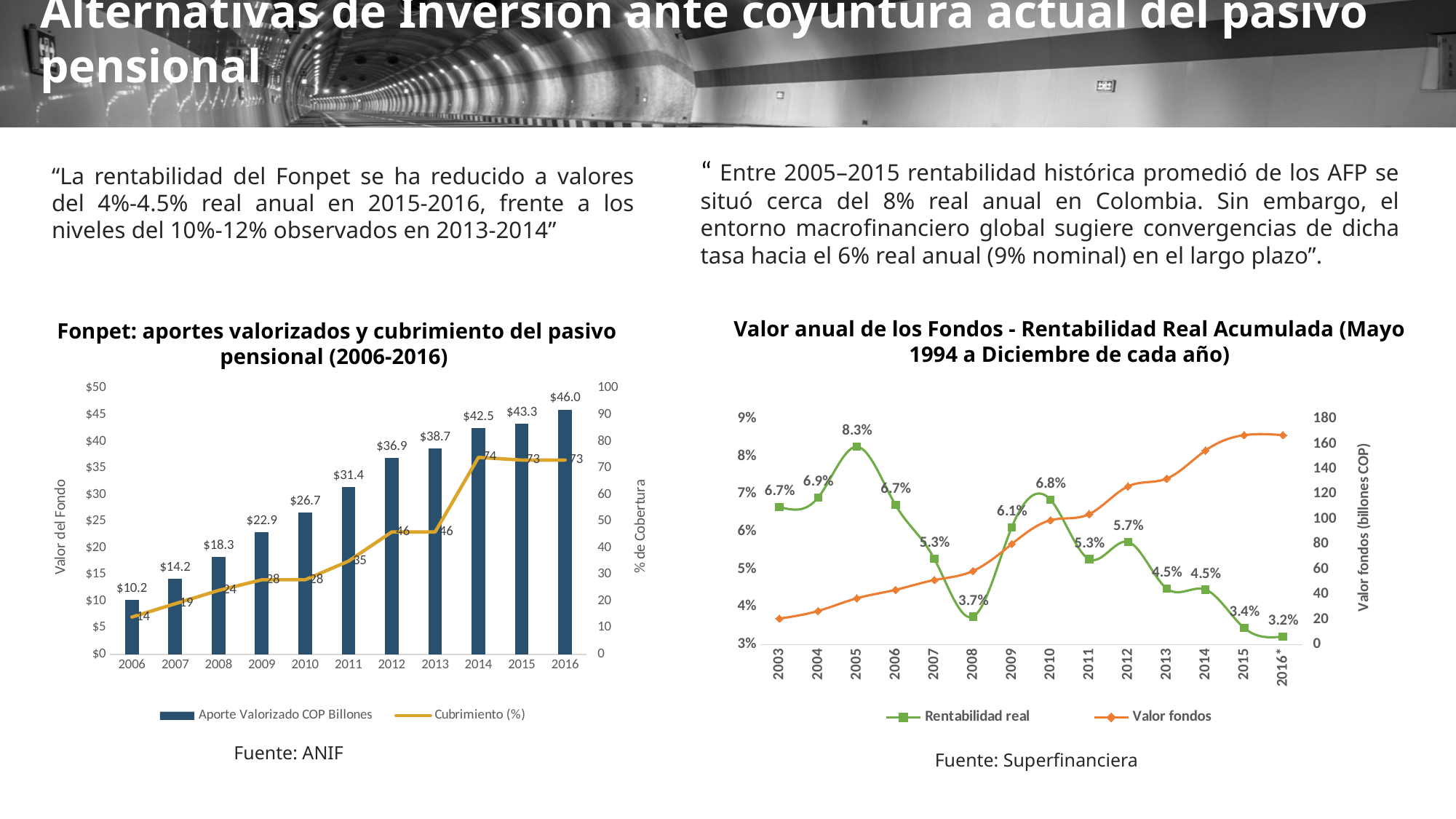
In the chart 'Valor anual de los Fondos - Rentabilidad Real Acumulada', is the Valor fondos value for 2016* greater or less than 140? greater In the chart 'Valor anual de los Fondos - Rentabilidad Real Acumulada', which is larger, the Rentabilidad real for 2009 or for 2012? 2009 In the chart 'Fonpet: aportes valorizados y cubrimiento del pasivo pensional (2006-2016)', what is the difference in Aporte Valorizado COP Billones between 2016 and 2006? $35.8 In the chart 'Valor anual de los Fondos - Rentabilidad Real Acumulada', how many series does the legend list? 2 In the chart 'Valor anual de los Fondos - Rentabilidad Real Acumulada', which year has the lowest Rentabilidad real? 2016* In the chart 'Fonpet: aportes valorizados y cubrimiento del pasivo pensional (2006-2016)', what is the Aporte Valorizado COP Billones value for 2012? $36.9 What kind of chart is 'Valor anual de los Fondos - Rentabilidad Real Acumulada'? line chart In the chart 'Fonpet: aportes valorizados y cubrimiento del pasivo pensional (2006-2016)', do the Aporte Valorizado bars rise or fall from 2006 to 2016? rise In the chart 'Fonpet: aportes valorizados y cubrimiento del pasivo pensional (2006-2016)', how many years are shown on the x axis? 11 In the chart 'Fonpet: aportes valorizados y cubrimiento del pasivo pensional (2006-2016)', what is the Cubrimiento (%) value for 2014? 74 In the chart 'Valor anual de los Fondos - Rentabilidad Real Acumulada', what is the Rentabilidad real value for 2005? 8.3% In the chart 'Fonpet: aportes valorizados y cubrimiento del pasivo pensional (2006-2016)', which year has the highest Aporte Valorizado COP Billones? 2016